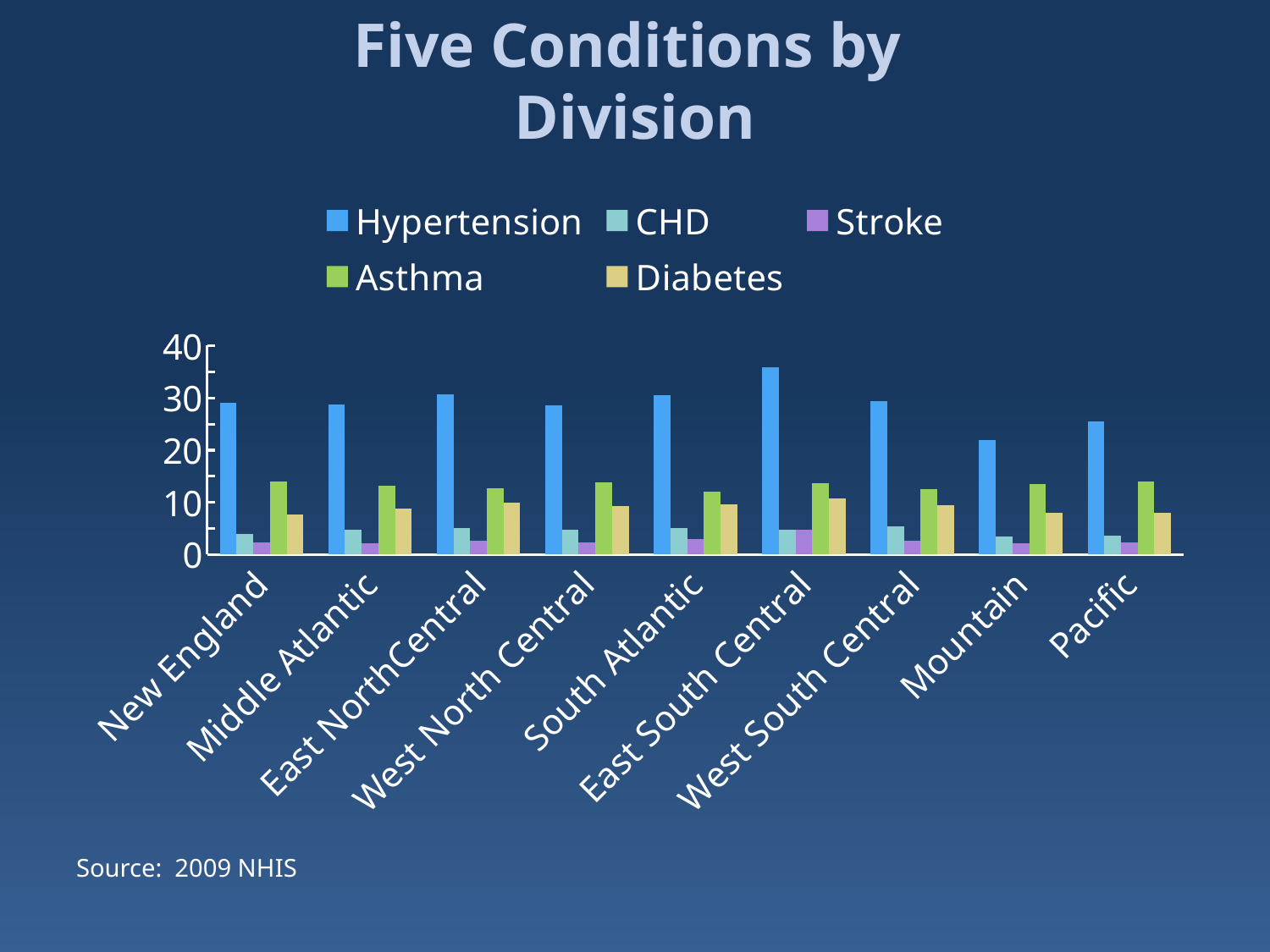
Is the Asthma value for Pacific greater or less than 10? greater Is the Hypertension value for East South Central greater or less than 30? greater How many divisions are shown on the x axis? 9 Which division has the highest Hypertension value? East South Central How many series does the legend list? 5 Which is larger, the Hypertension value for East South Central or for Mountain? East South Central Which division has the lowest Hypertension value? Mountain Is the Stroke value for New England greater or less than 10? less What is the title of the chart? Five Conditions by Division In New England, which is larger, the Asthma value or the Diabetes value? Asthma What kind of chart is shown on the slide? bar chart